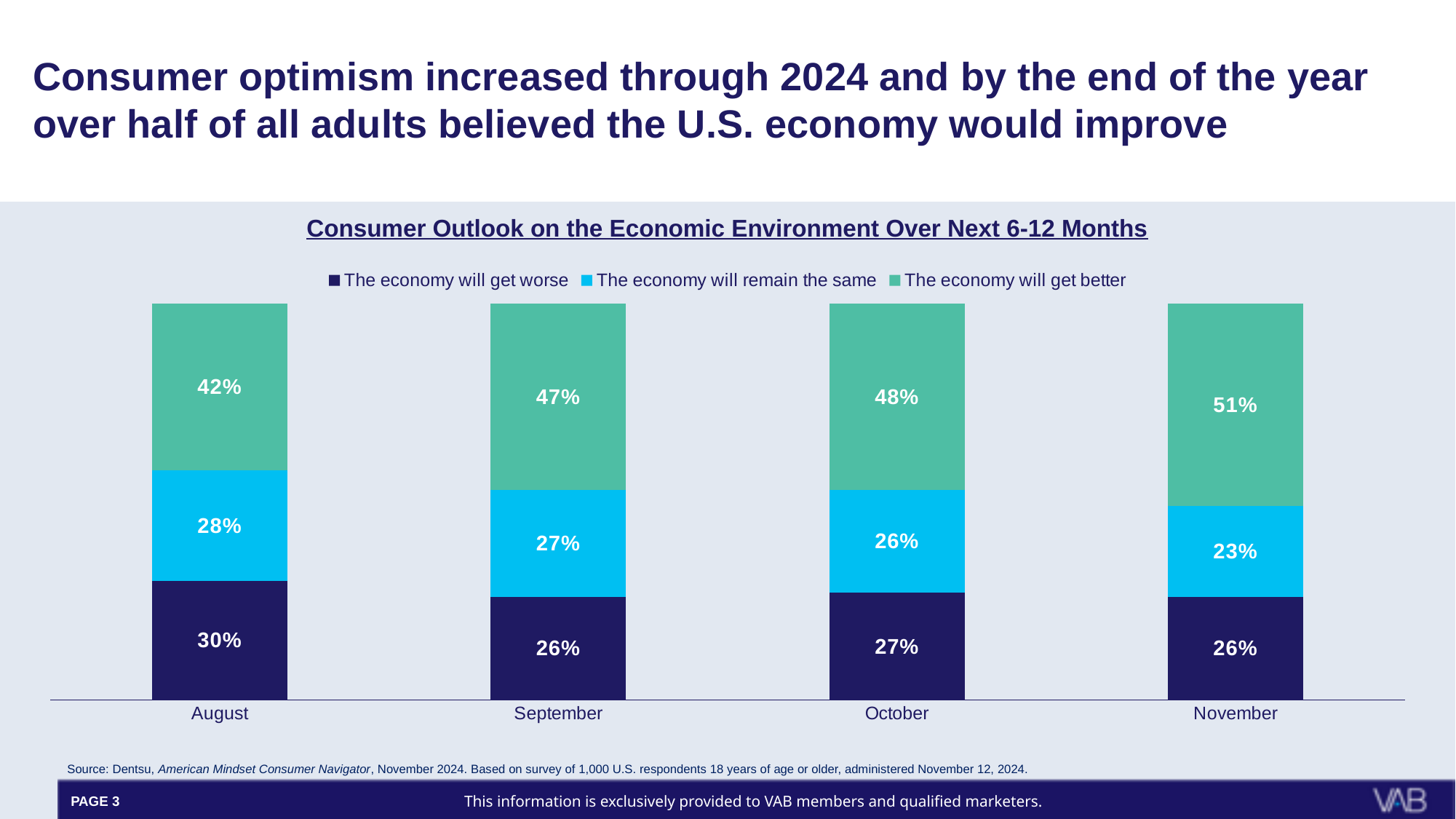
In which month was the share saying the economy will get better the highest? November Does the share saying the economy will get better rise or fall from August to November? Rise By how many percentage points did the share saying the economy will get better increase from August to November? 9 percentage points What percentage of respondents in August said the economy will get worse? 30% How many series does the legend list? 3 What is the title of the chart? Consumer Outlook on the Economic Environment Over Next 6-12 Months How many months are shown on the x axis? 4 What kind of chart is shown? Stacked bar chart Which is larger: the share saying the economy will get worse in August or in September? August What percentage of respondents in October said the economy will remain the same? 26% In which month was the share saying the economy will remain the same the lowest? November What percentage of respondents in November said the economy will get better? 51%